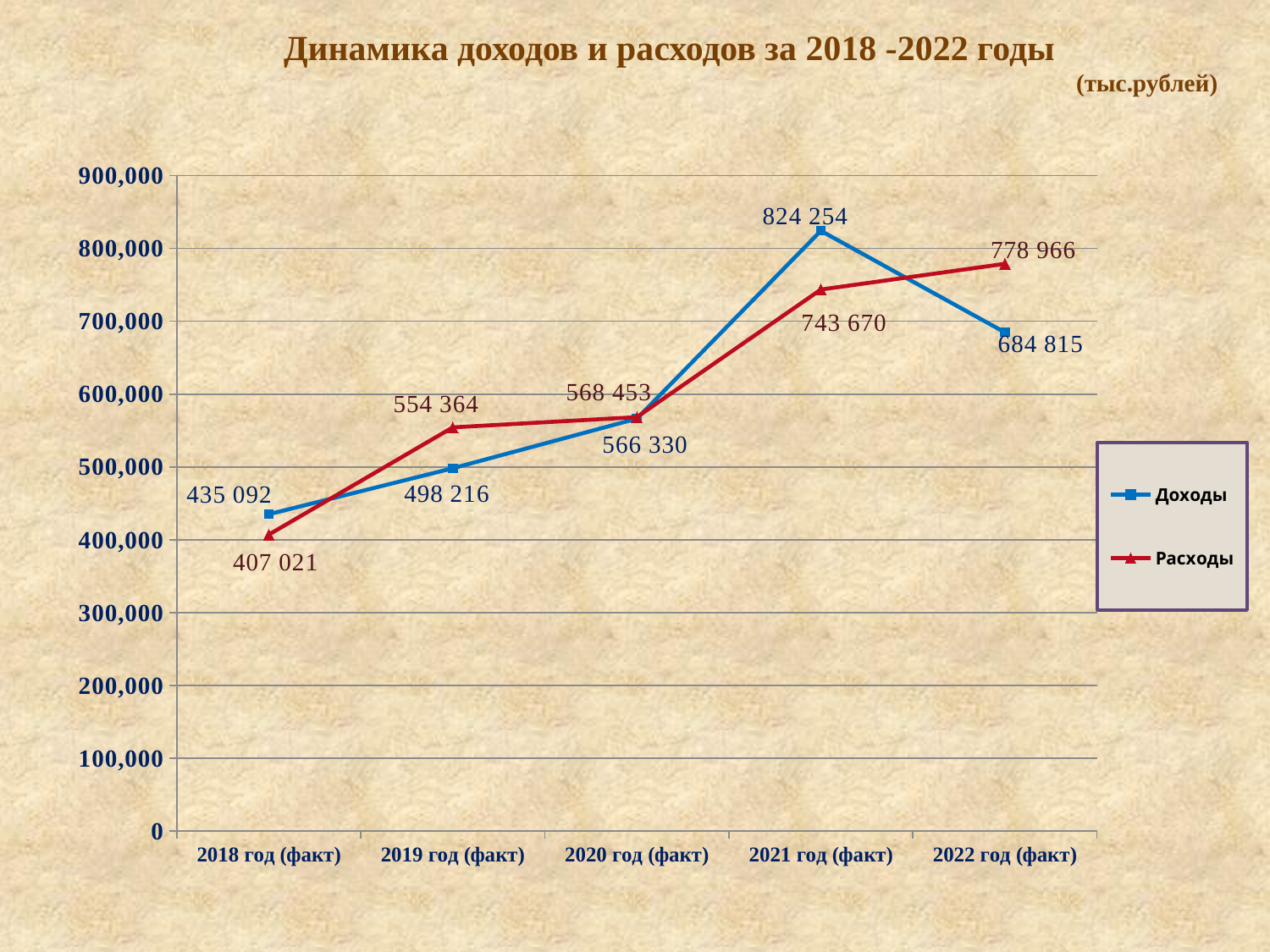
What is the value of Расходы for 2018 год (факт)? 407 021 Which is larger in 2022 год (факт), Доходы or Расходы? Расходы What is the value of Расходы for 2022 год (факт)? 778 966 Is the value of Доходы for 2022 год (факт) greater or less than 700,000? less In which year is Доходы highest? 2021 год (факт) How many series does the legend list? 2 What is the value of Доходы for 2021 год (факт)? 824 254 How many years are plotted along the x axis? 5 What is the difference between Доходы and Расходы in 2021 год (факт)? 80 584 What is the value of Доходы for 2019 год (факт)? 498 216 In which year is Расходы lowest? 2018 год (факт) What type of chart is shown on the slide? line chart